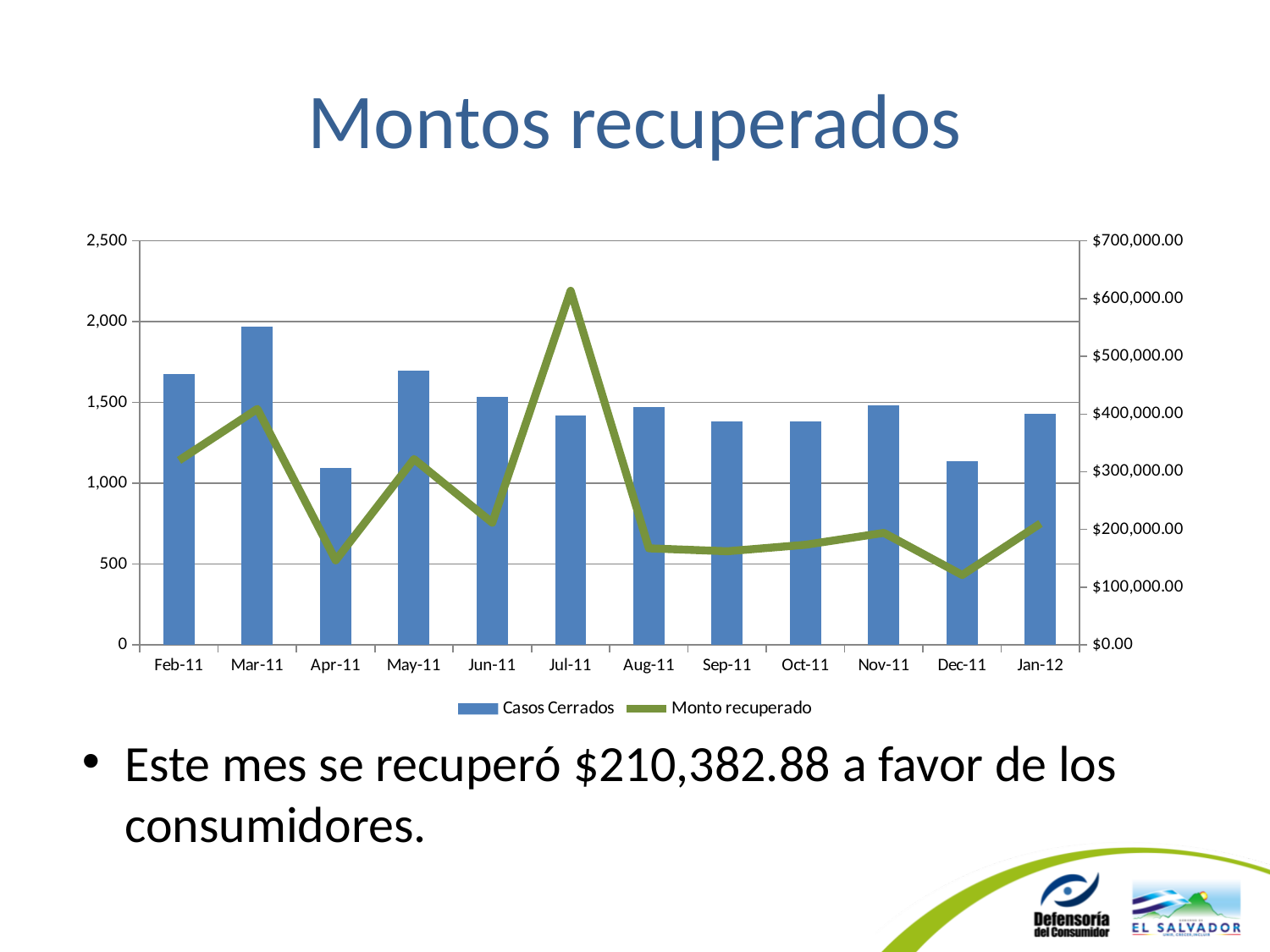
Which month has the highest Monto recuperado? Jul-11 How many months are shown on the x axis? 12 How many series does the legend list? 2 Which series is drawn as a line? Monto recuperado What is the title of the chart? Montos recuperados What kind of chart is this? A combined bar and line chart Is the Monto recuperado for Dec-11 greater or less than $200,000.00? less Which month has more Casos Cerrados, May-11 or Jun-11? May-11 Which month has the highest number of Casos Cerrados? Mar-11 Which month has the lowest number of Casos Cerrados? Apr-11 Is the Monto recuperado for Jul-11 greater or less than $500,000.00? greater Is the number of Casos Cerrados for Mar-11 greater or less than 1,500? greater